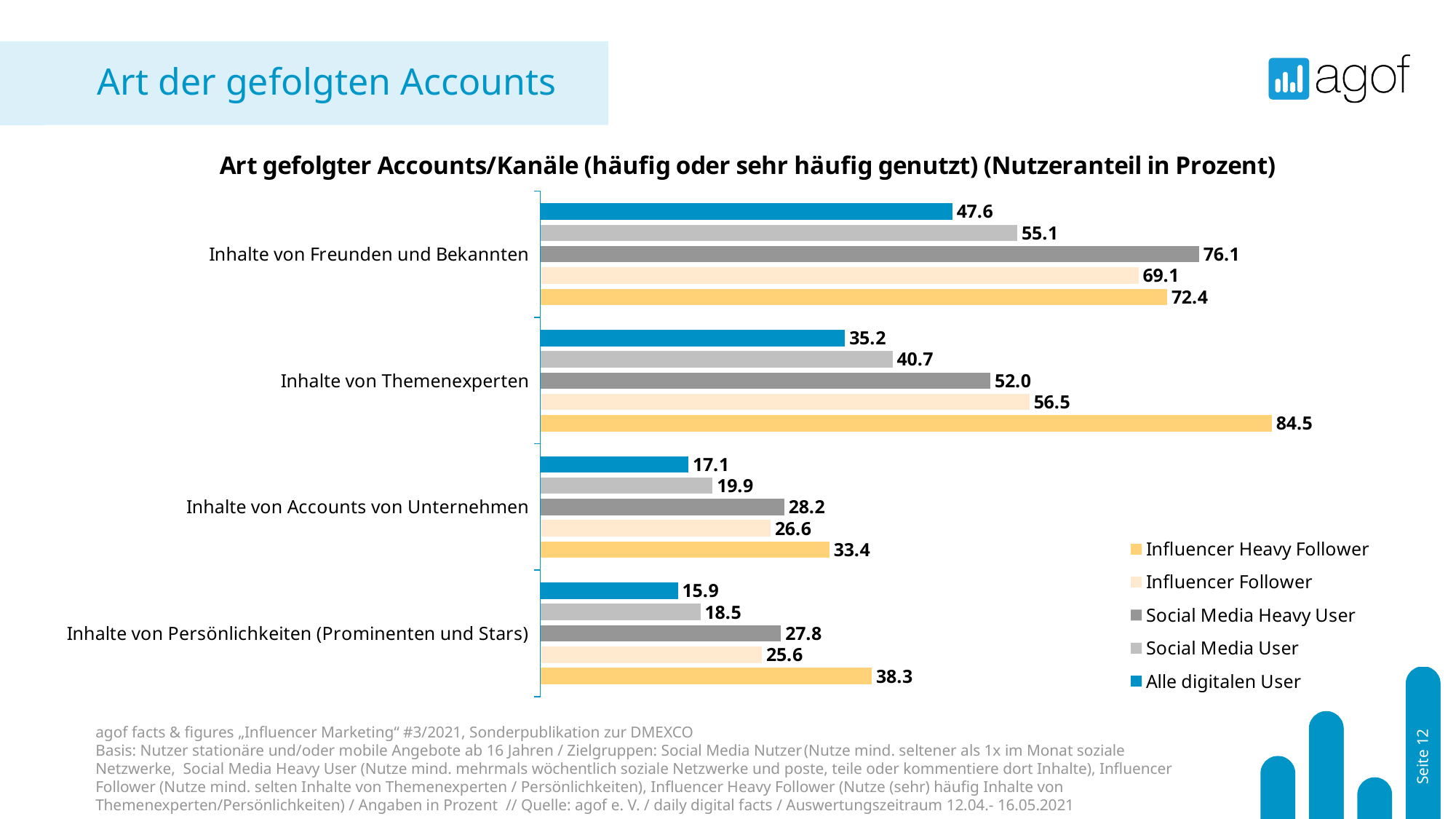
What is the value for Social Media User in the category 'Inhalte von Persönlichkeiten (Prominenten und Stars)'? 18.5 How many categories are shown on the chart? 4 What is the value for Influencer Heavy Follower in the category 'Inhalte von Themenexperten'? 84.5 How many series does the legend list? 5 Which is larger for 'Inhalte von Freunden und Bekannten': the Social Media Heavy User value or the Influencer Heavy Follower value? Social Media Heavy User Which series is shown in blue in the legend? Alle digitalen User What is the value for Alle digitalen User in the category 'Inhalte von Freunden und Bekannten'? 47.6 Which category has the highest value for Social Media Heavy User? Inhalte von Freunden und Bekannten What is the difference between the Influencer Heavy Follower and Alle digitalen User values for 'Inhalte von Themenexperten'? 49.3 What is the difference between the Social Media Heavy User and Social Media User values for 'Inhalte von Accounts von Unternehmen'? 8.3 What kind of chart is shown on the slide? Bar chart Which category has the lowest value for Influencer Follower? Inhalte von Persönlichkeiten (Prominenten und Stars)